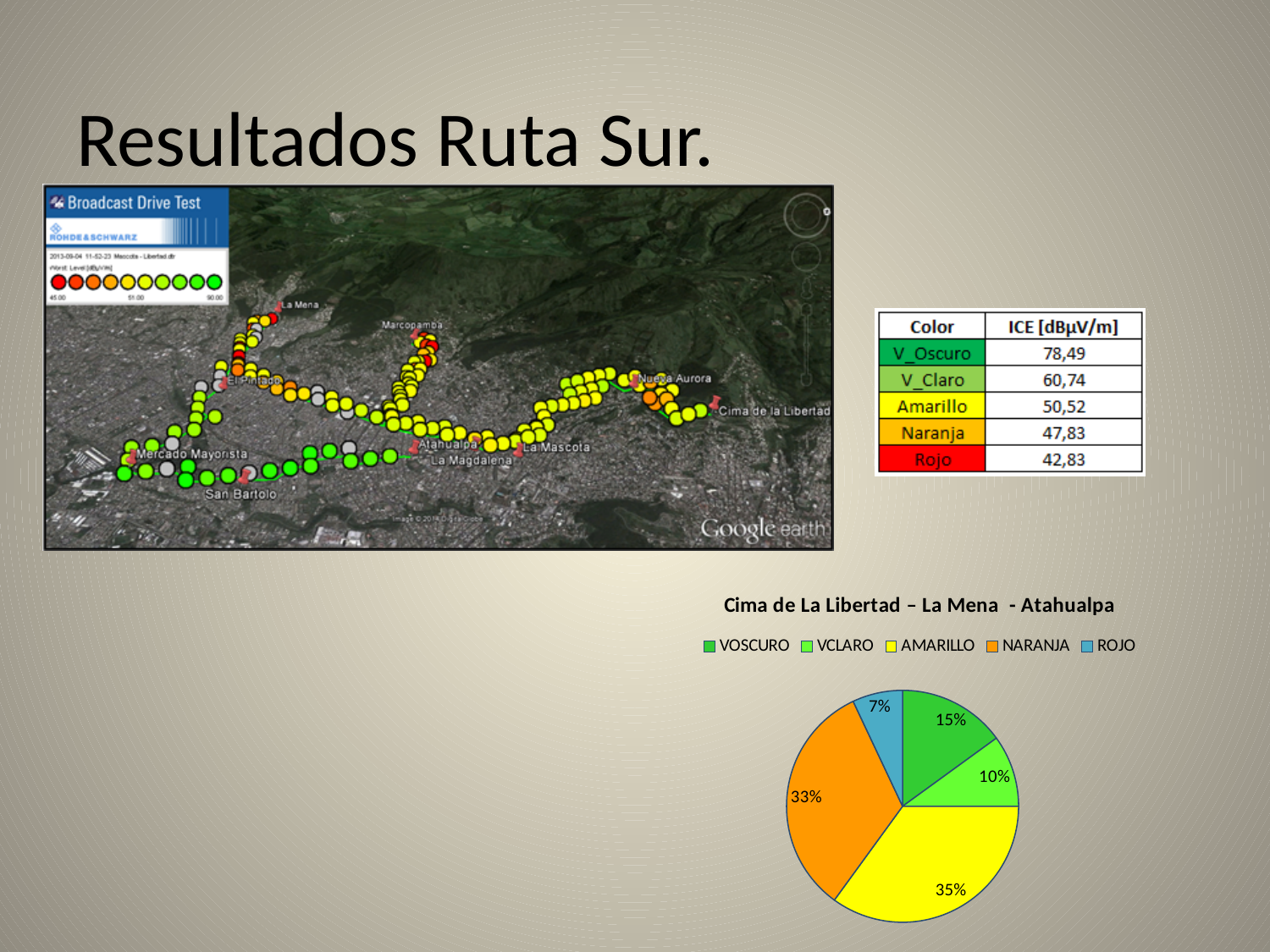
What share of the pie chart does NARANJA represent? 33% What share of the pie chart does AMARILLO represent? 35% What share of the pie chart does ROJO represent? 7% How many series does the pie chart legend list? 5 In the pie chart, which is larger, the NARANJA share or the VOSCURO share? NARANJA In the pie chart, what is the difference between the VOSCURO share and the VCLARO share? 5% What is the title of the pie chart? Cima de La Libertad – La Mena - Atahualpa What kind of chart is shown at the bottom right of the slide? pie chart Which category has the largest slice in the pie chart? AMARILLO Which category has the smallest slice in the pie chart? ROJO